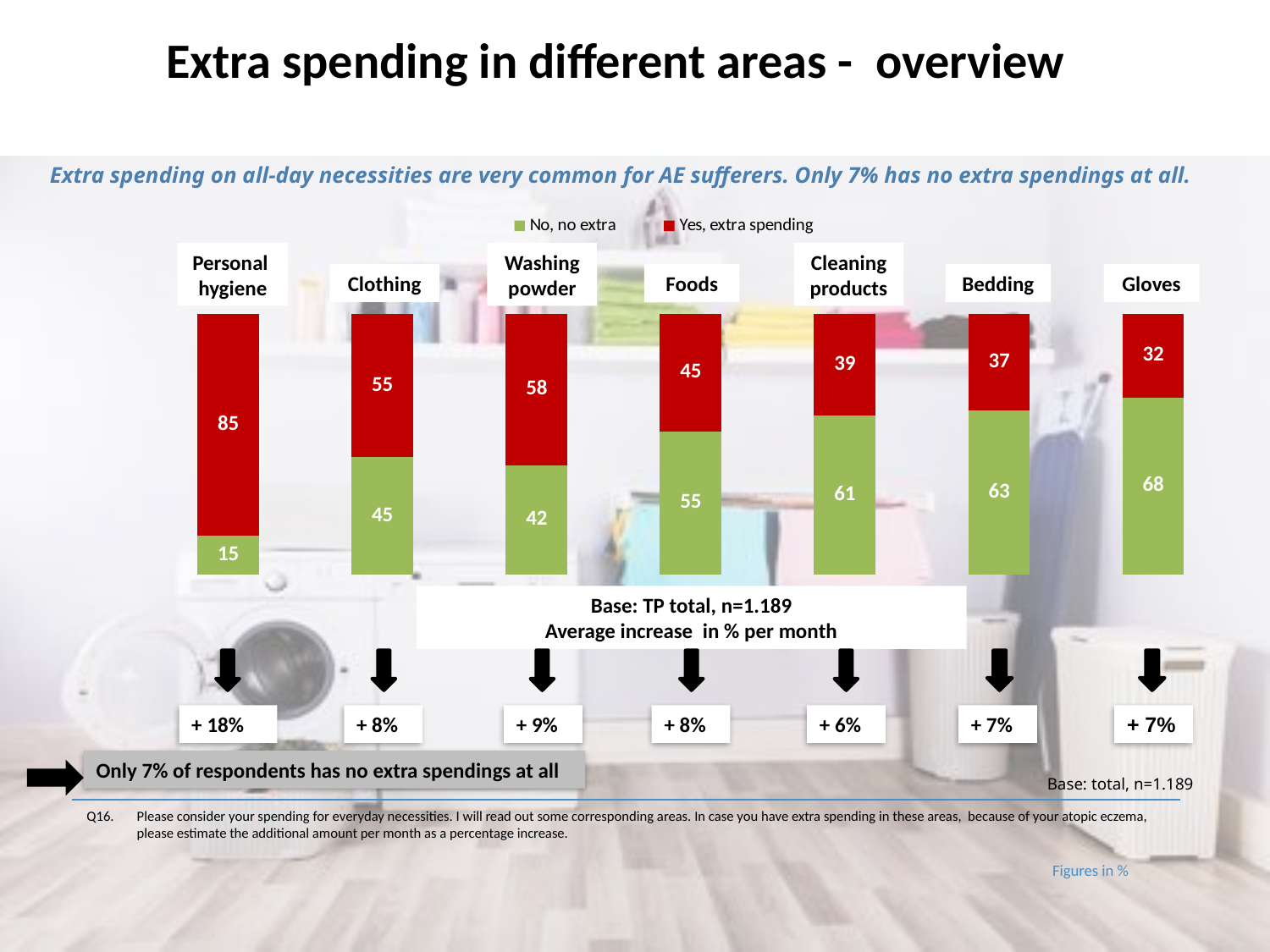
What is the 'Yes, extra spending' value for Personal hygiene? 85 Which colour represents 'Yes, extra spending' in the chart? Red Which is larger: the 'No, no extra' value for Cleaning products or for Washing powder? Cleaning products What is the 'No, no extra' value for Gloves? 68 What is the difference between the 'Yes, extra spending' values for Clothing and Bedding? 18 How many categories are shown in the chart? 7 Which category has the highest 'Yes, extra spending' value? Personal hygiene Which category has the lowest 'No, no extra' value? Personal hygiene What kind of chart is shown on the slide? Stacked bar chart What is the total of the stacked bar for Washing powder? 100 What is the 'Yes, extra spending' value for Foods? 45 How many series does the legend list? 2